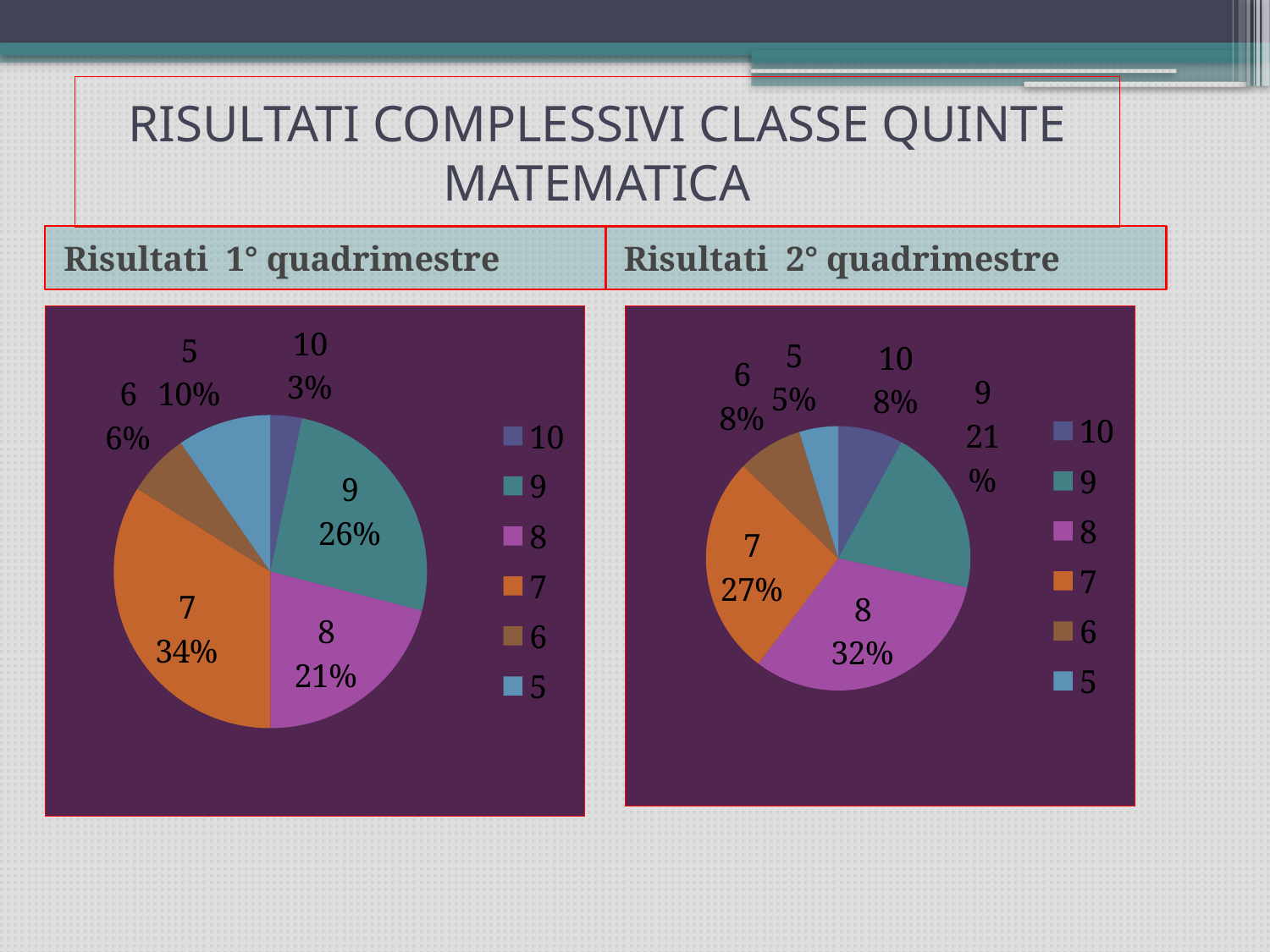
In the 'Risultati 2° quadrimestre' chart, which grade has the smallest slice? 5 In the 'Risultati 2° quadrimestre' chart, what percentage is shown for grade 8? 32% In the 'Risultati 1° quadrimestre' chart, which grade has the smallest slice? 10 How many slices does the 'Risultati 2° quadrimestre' pie chart have? 6 In the 'Risultati 1° quadrimestre' chart, which grade has the largest slice? 7 In the 'Risultati 1° quadrimestre' chart, what share of the pie does grade 7 have? 34% In the 'Risultati 1° quadrimestre' chart, what percentage is shown for grade 10? 3% In the 'Risultati 2° quadrimestre' chart, what percentage is shown for grade 9? 21% In the 'Risultati 2° quadrimestre' chart, which grade has the largest slice? 8 What type of chart is used for 'Risultati 1° quadrimestre'? Pie chart In the 'Risultati 2° quadrimestre' chart, which is larger, the slice for grade 7 or the slice for grade 9? 7 In the 'Risultati 1° quadrimestre' chart, what is the difference in percentage points between grade 7 and grade 8? 13